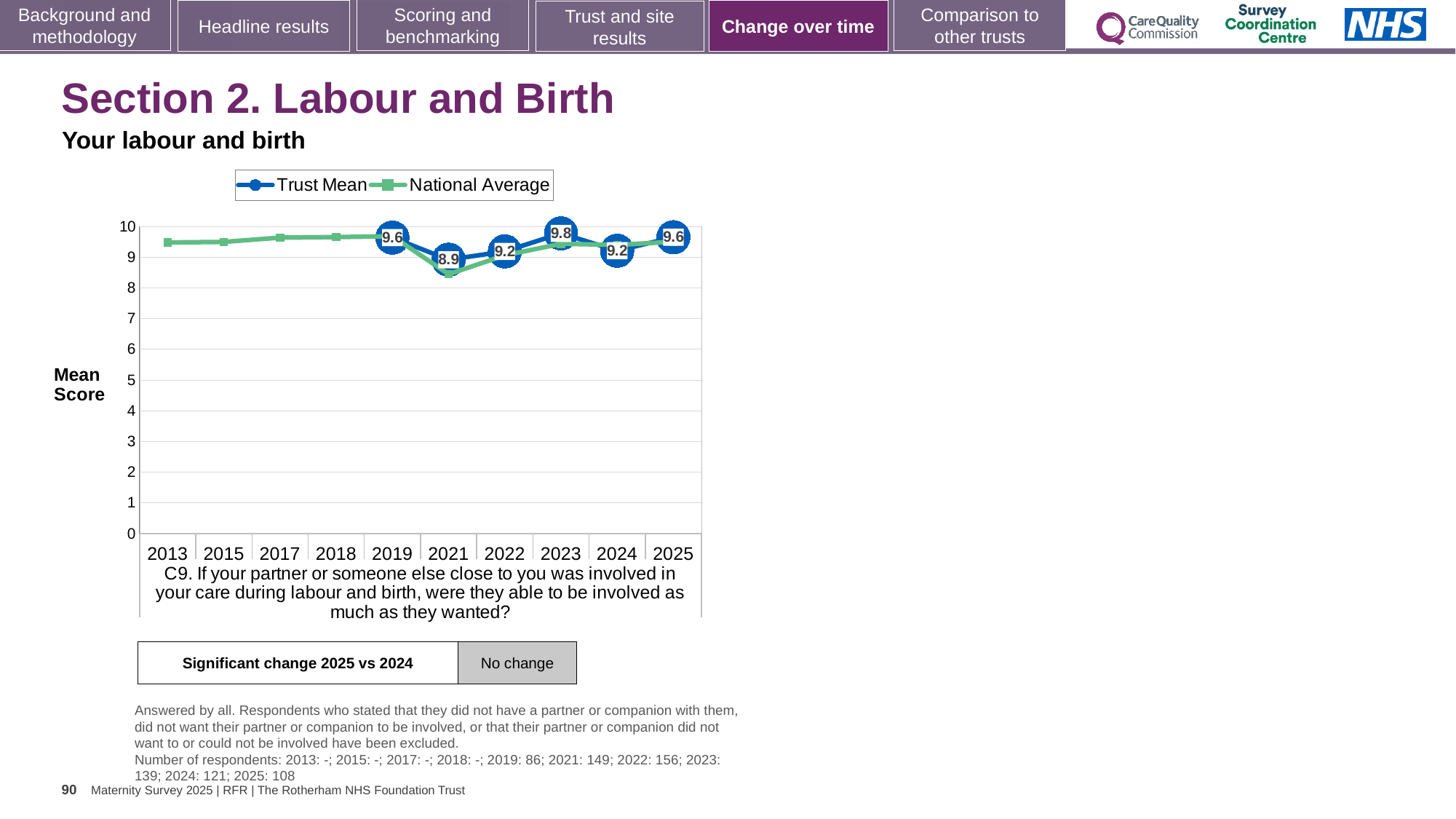
Does the Trust Mean rise or fall from 2024 to 2025? Rise In which year is the Trust Mean lowest? 2021 What is the Trust Mean value for 2025? 9.6 What is the difference between the Trust Mean in 2023 and in 2021? 0.9 Which is larger, the Trust Mean in 2019 or in 2024? 2019 In which year is the Trust Mean highest? 2023 What is the Trust Mean value for 2021? 8.9 How many series does the legend list? 2 What is the Trust Mean value for 2023? 9.8 What kind of chart is shown on the slide? Line chart How many years are shown on the x axis? 10 Is the National Average value for 2013 greater or less than 9? greater